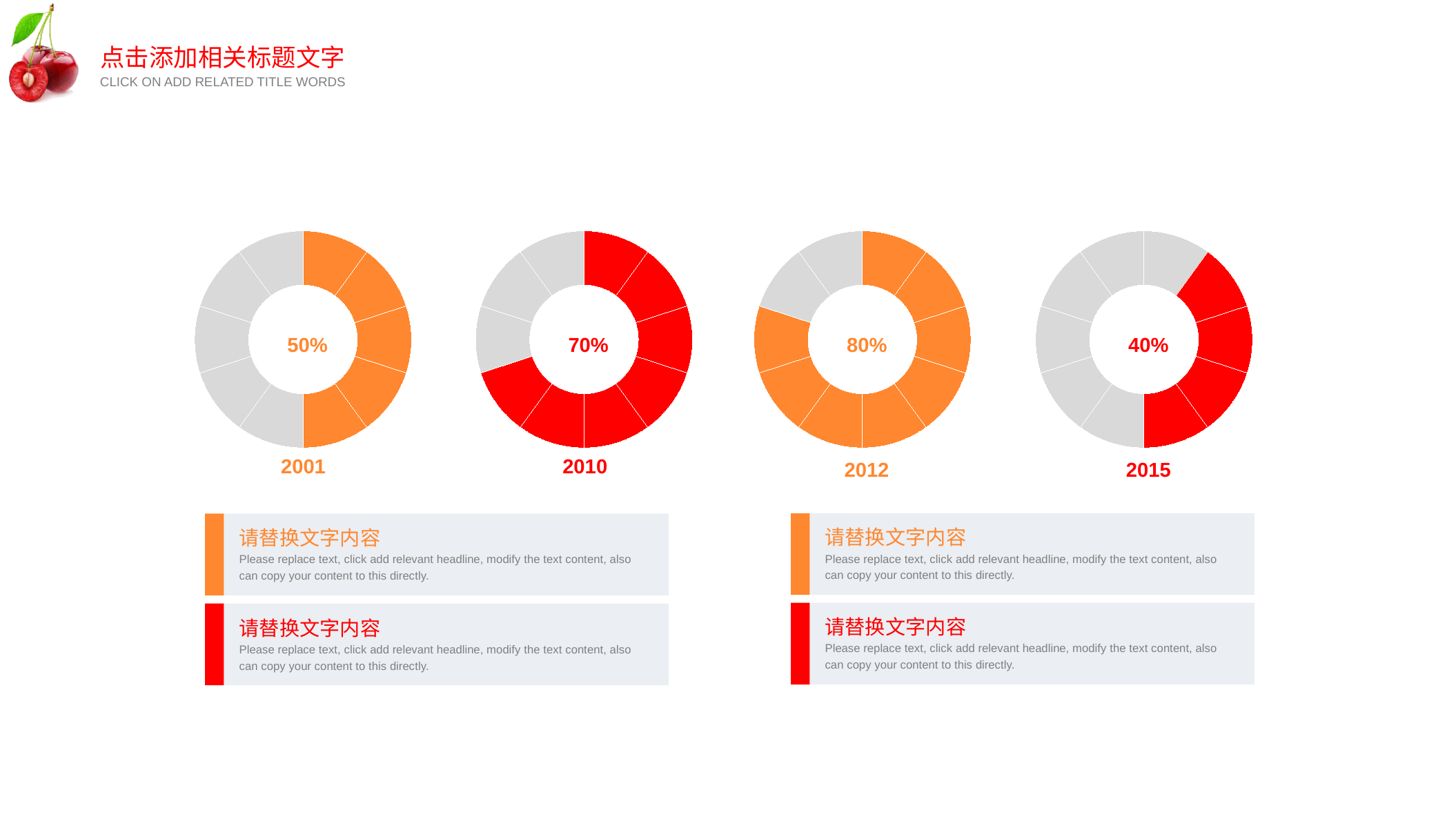
What percentage is shown in the centre of the 2001 donut chart? 50% What percentage is shown in the centre of the 2010 donut chart? 70% Which is larger, the percentage shown for 2010 or the percentage shown for 2015? 2010 Which year's donut chart shows the highest percentage? 2012 What colour is the filled portion of the 2012 donut chart? Orange What kind of chart is used to show the percentage for each year? Donut chart What colour is the filled portion of the 2010 donut chart? Red Which year's donut chart shows the lowest percentage? 2015 How many donut charts are on the slide? 4 What is the difference between the percentage shown for 2012 and the percentage shown for 2001? 30% What percentage is shown in the centre of the 2012 donut chart? 80% What percentage is shown in the centre of the 2015 donut chart? 40%